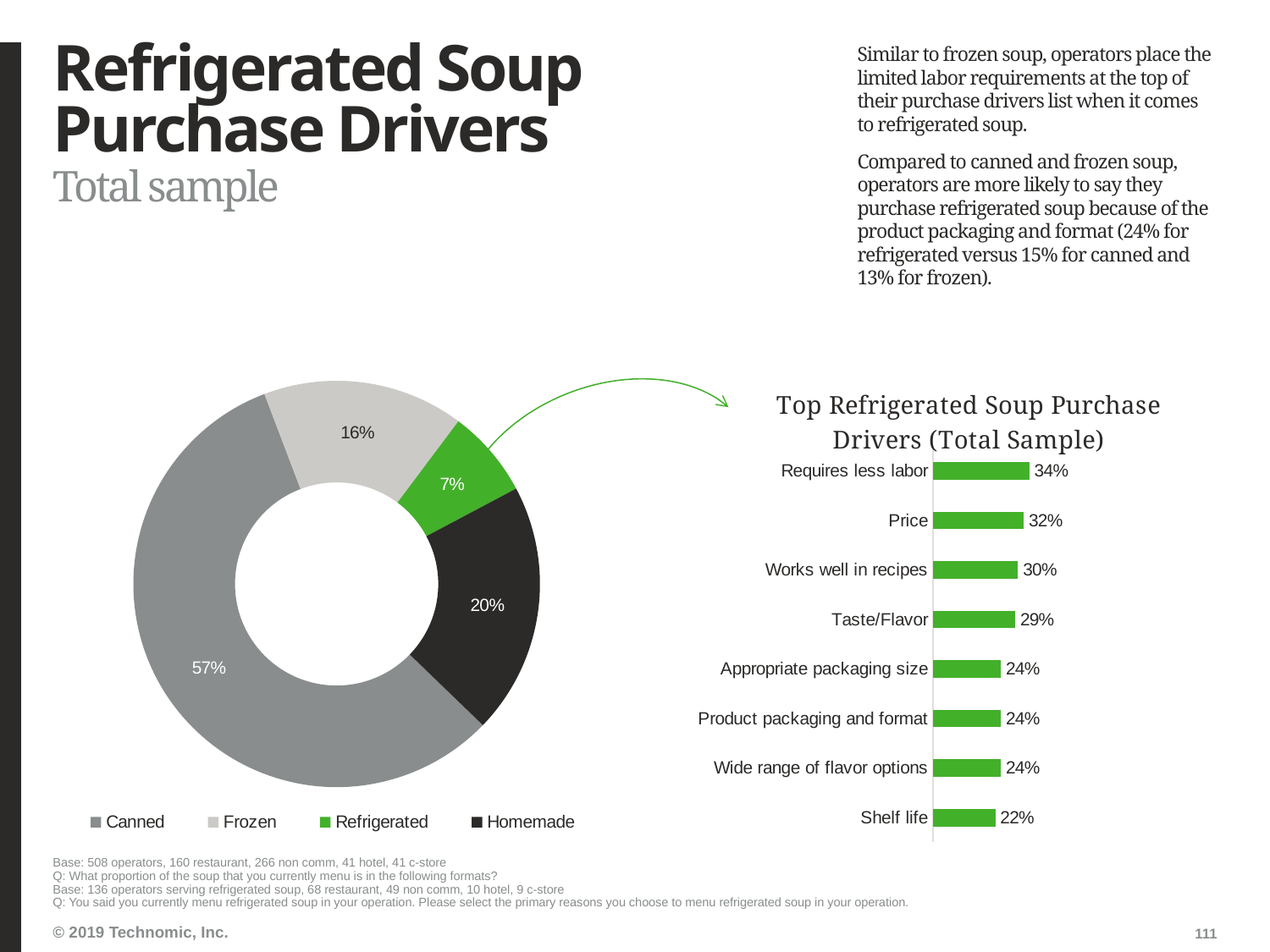
In the 'Top Refrigerated Soup Purchase Drivers (Total Sample)' chart, which driver has the lowest value? Shelf life What kind of chart is the 'Top Refrigerated Soup Purchase Drivers (Total Sample)' chart? Bar chart In the donut chart on the left, which category has the largest share? Canned In the donut chart on the left, what is the difference between the Homemade and Frozen shares? 4% In the 'Top Refrigerated Soup Purchase Drivers (Total Sample)' chart, how many drivers are shown? 8 In the 'Top Refrigerated Soup Purchase Drivers (Total Sample)' chart, what is the value for Shelf life? 22% In the donut chart on the left, which category has the smallest share? Refrigerated In the donut chart on the left, what share does Refrigerated have? 7% In the 'Top Refrigerated Soup Purchase Drivers (Total Sample)' chart, what is the value for Requires less labor? 34% In the donut chart on the left, how many categories does the legend list? 4 In the donut chart on the left, what share does Canned have? 57% In the 'Top Refrigerated Soup Purchase Drivers (Total Sample)' chart, what is the difference between Price and Taste/Flavor? 3%